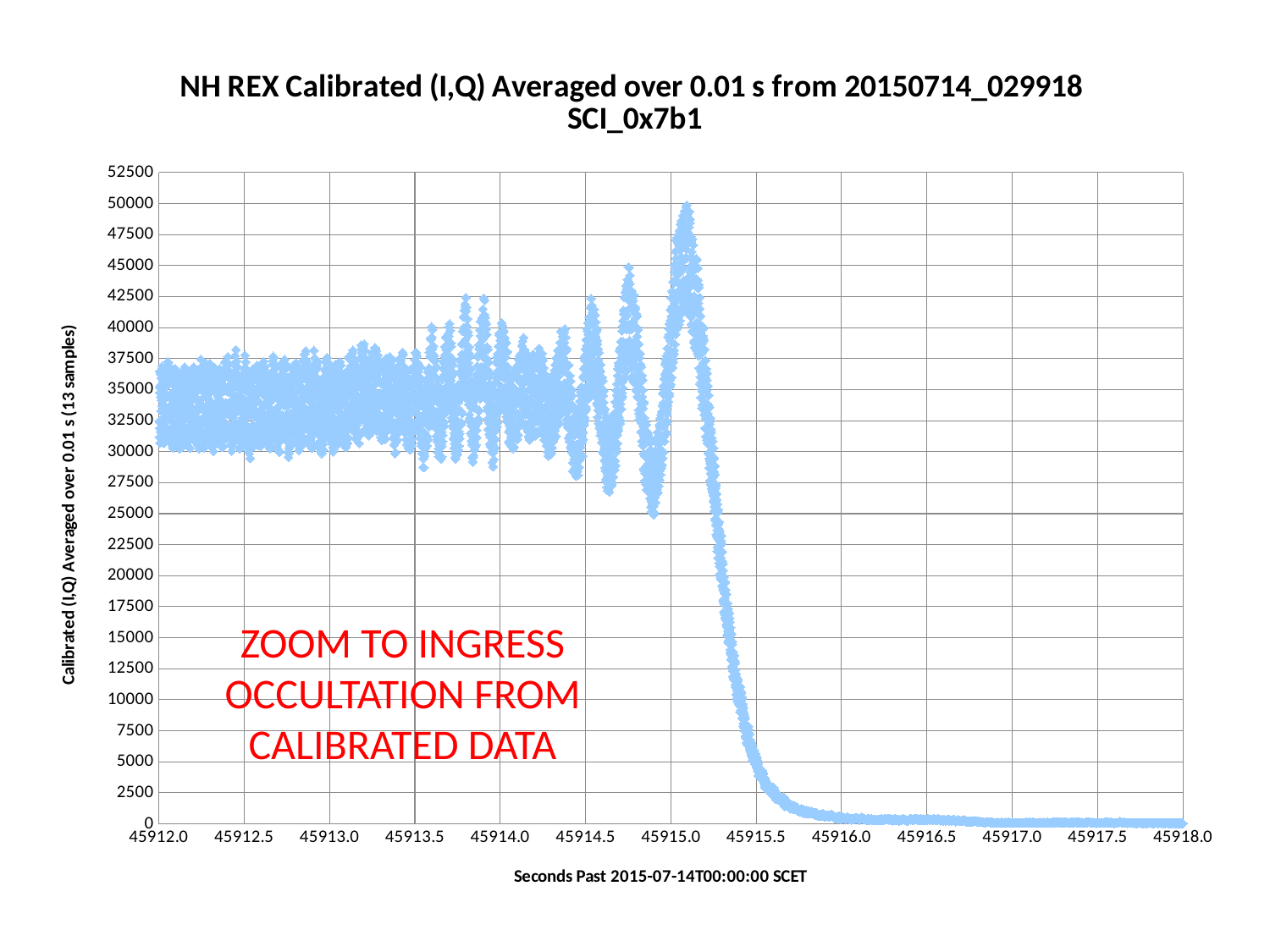
What is the highest value shown on the y axis? 52500 What kind of chart is shown on the slide? Scatter chart Is the plotted value at 45912.5 greater or less than 25000? greater Is the plotted value at 45916.0 greater or less than 5000? less Is the highest plotted value greater or less than 47500? greater Which has the larger plotted value, the point at 45913.0 or the point at 45917.0? 45913.0 Between which two x-axis ticks does the sharp drop in the plotted values occur? 45915.0 and 45915.5 Do the plotted values overall rise or fall from the left of the x axis to the right? Fall What is the label of the x axis? Seconds Past 2015-07-14T00:00:00 SCET Between which two x-axis ticks does the highest plotted value occur? 45915.0 and 45915.5 What is the title of the chart? NH REX Calibrated (I,Q) Averaged over 0.01 s from 20150714_029918 SCI_0x7b1